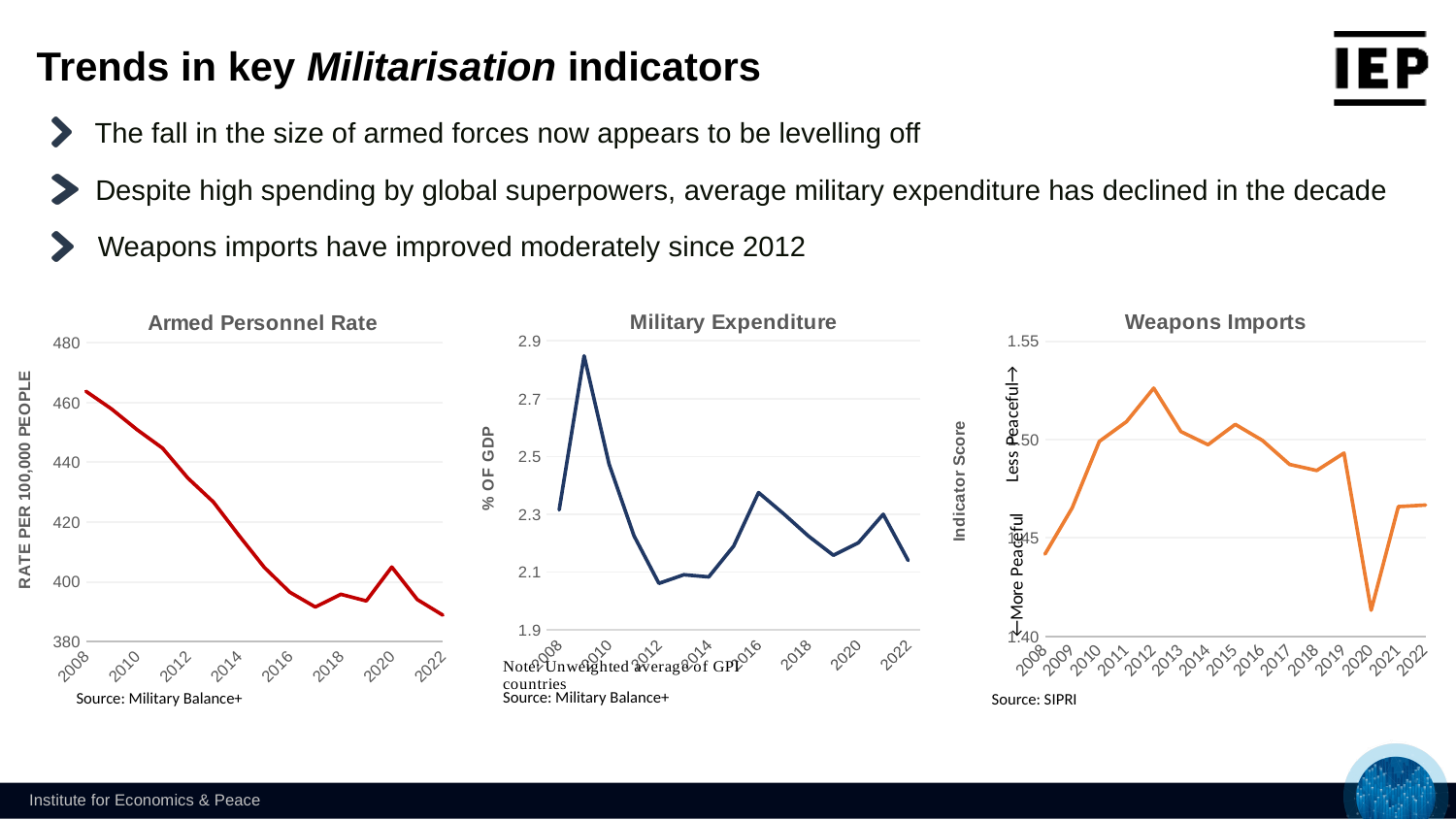
In the Weapons Imports chart, is the value for 2020 greater or less than 1.45? less In the Military Expenditure chart, which year has the highest value? 2009 In the Military Expenditure chart, is the value for 2022 greater or less than 2.3? less What is the y-axis label of the Armed Personnel Rate chart? RATE PER 100,000 PEOPLE In the Weapons Imports chart, which year has the highest value? 2012 In the Armed Personnel Rate chart, do values generally rise or fall from 2008 to 2022? fall In the Armed Personnel Rate chart, is the value for 2022 greater or less than 400? less In the Military Expenditure chart, which is larger, the value for 2009 or the value for 2022? 2009 In the Weapons Imports chart, which year has the lowest value? 2020 What kind of chart is the Armed Personnel Rate chart? line chart In the Armed Personnel Rate chart, which year has the highest value? 2008